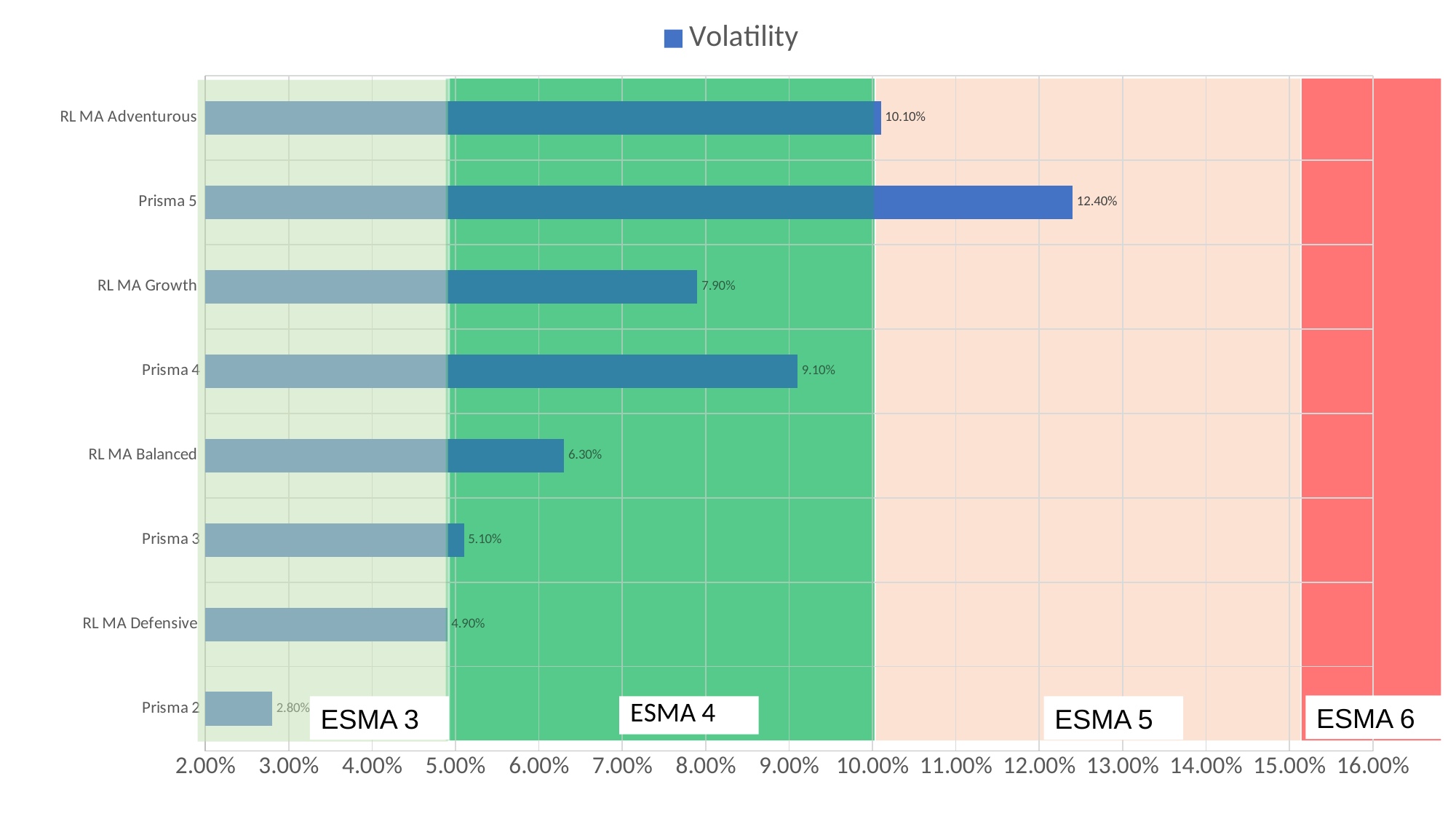
Which category has the highest volatility? Prisma 5 What series name is shown in the chart legend? Volatility What is the difference in volatility between Prisma 5 and RL MA Adventurous? 2.30% How many categories are shown on the chart? 8 What is the volatility value for Prisma 5? 12.40% What is the difference in volatility between Prisma 4 and RL MA Growth? 1.20% Which has a higher volatility, RL MA Growth or Prisma 4? Prisma 4 What is the volatility value for RL MA Balanced? 6.30% Is the volatility for RL MA Adventurous greater or less than 10.00%? greater What is the volatility value for Prisma 2? 2.80% What kind of chart is shown on the slide? Bar chart Which category has the lowest volatility? Prisma 2